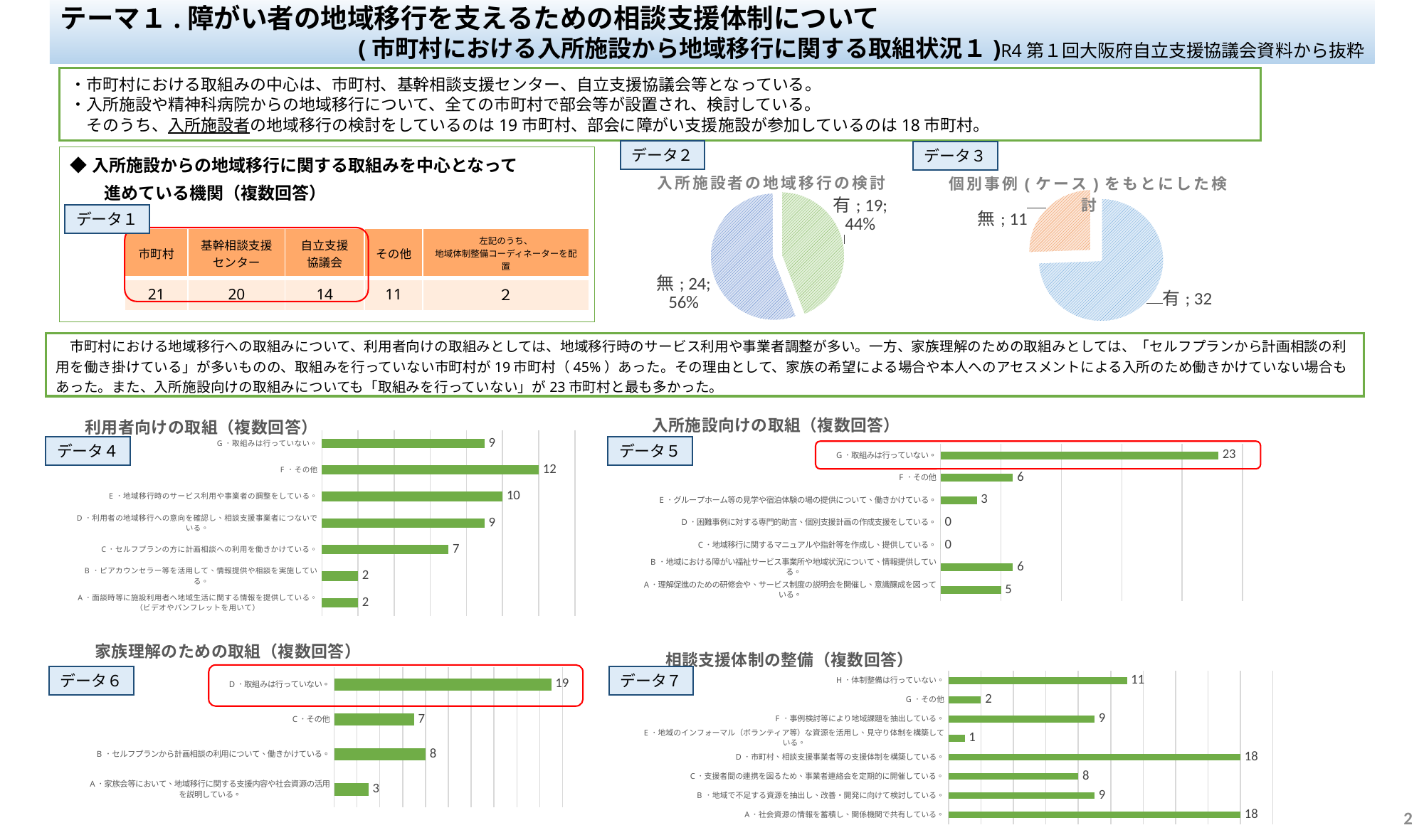
In the bar chart titled 入所施設向けの取組（複数回答） (データ5), how many categories are plotted? 7 In the bar chart titled 利用者向けの取組（複数回答） (データ4), which category has the highest value? F・その他 In the bar chart titled 家族理解のための取組（複数回答） (データ6), which category has the lowest value? A・家族会等において、地域移行に関する支援内容や社会資源の活用を説明している In the pie chart titled 入所施設者の地域移行の検討 (データ2), what percentage share does 有 have? 44% In the bar chart titled 利用者向けの取組（複数回答） (データ4), what is the value for C・セルフプランの方に計画相談への利用を働きかけている? 7 In the bar chart titled 家族理解のための取組（複数回答） (データ6), what is the difference between D・取組みは行っていない and C・その他? 12 In the pie chart titled 個別事例（ケース）をもとにした検討 (データ3), what is the value for 有? 32 In the bar chart titled 入所施設向けの取組（複数回答） (データ5), what is the value for G・取組みは行っていない? 23 In the pie chart titled 入所施設者の地域移行の検討 (データ2), what is the value for 無? 24 In the pie chart titled 個別事例（ケース）をもとにした検討 (データ3), what is the difference between 有 and 無? 21 In the bar chart titled 相談支援体制の整備（複数回答） (データ7), which is larger: H・体制整備は行っていない or C・支援者間の連携を図るため、事業者連絡会を定期的に開催している? H・体制整備は行っていない What kind of chart is データ7 (相談支援体制の整備（複数回答）)? bar chart